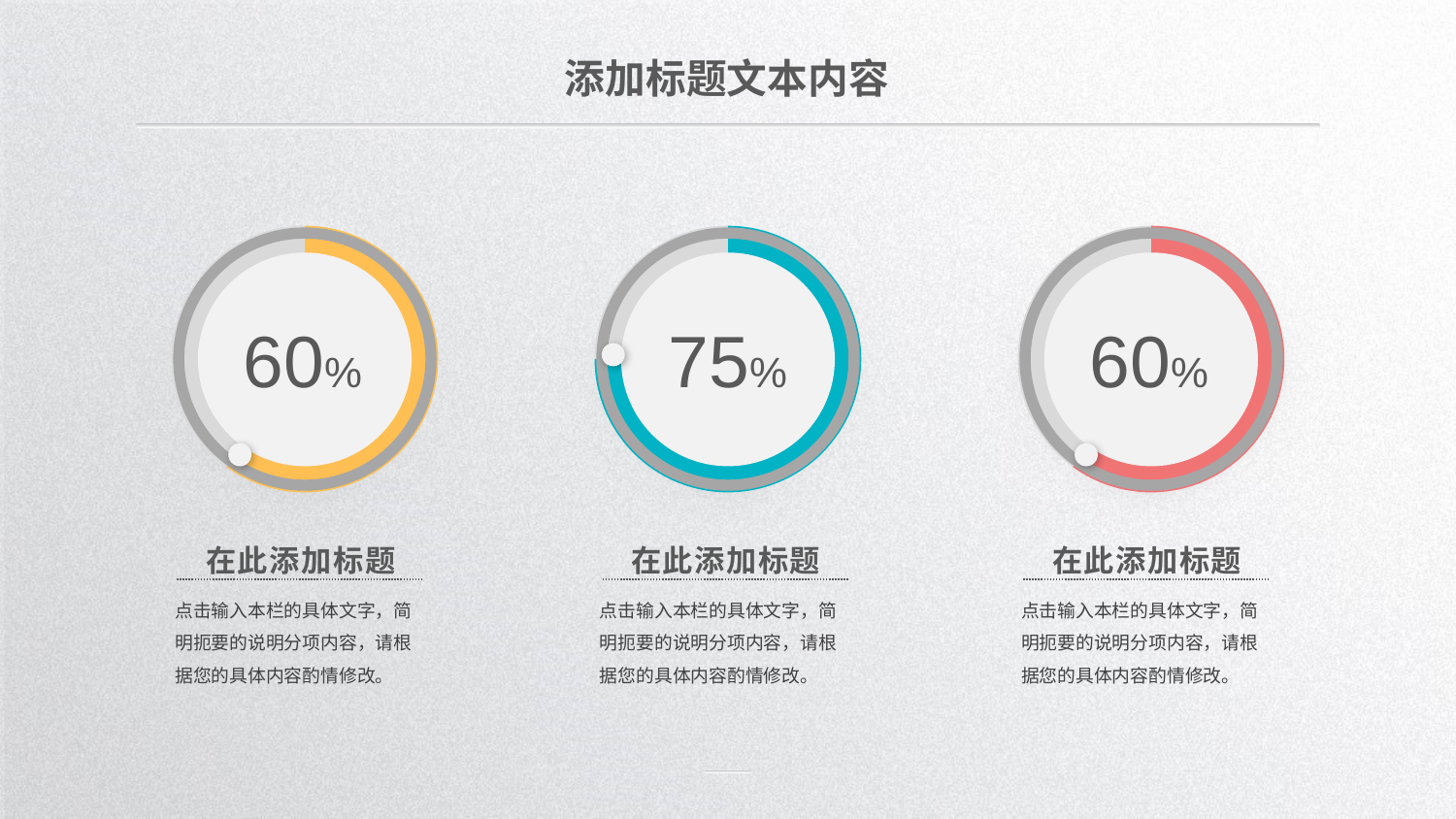
What colour is the filled ring of the middle circular chart? teal What colour is the filled ring of the left circular chart? yellow How many circular progress charts are on the slide? 3 Do the left and right circular charts show the same value? yes What value is shown in the middle circular chart? 75% What value is shown in the right circular chart? 60% What value is shown in the left circular chart? 60% What kind of chart is used on the slide? circular progress (ring) chart Is the value in the left circular chart greater or less than 50%? greater Which of the three circular charts shows the highest value? the middle one Is the value in the middle circular chart larger than the value in the right circular chart? yes What is the difference between the value in the middle circular chart and the value in the left circular chart? 15%